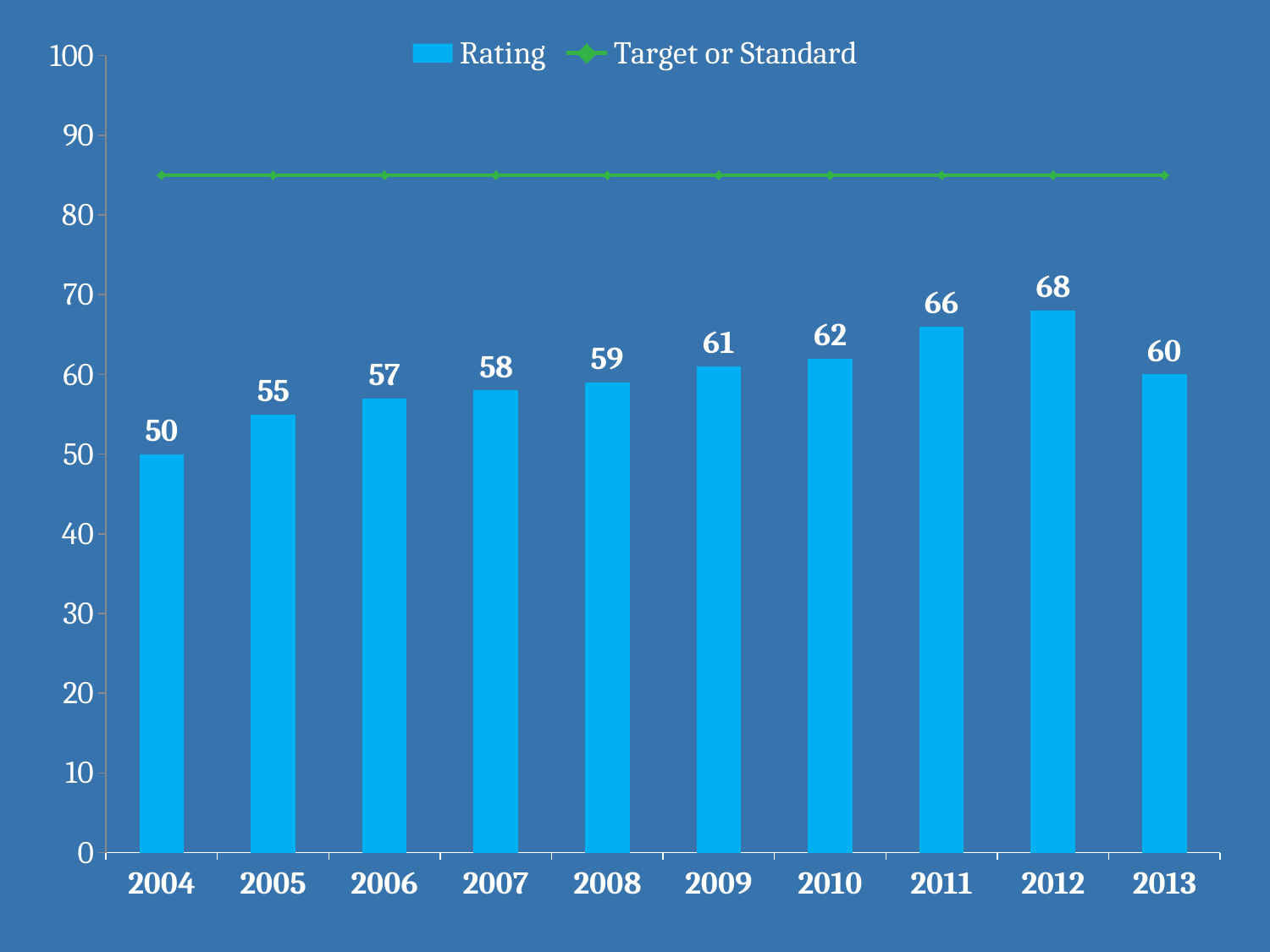
Is the Target or Standard line greater or less than 80? greater What is the Rating value for 2010? 62 What is the Rating value for 2004? 50 How many series does the legend list? 2 Which year has the lowest Rating? 2004 What kind of chart is used to show the Rating series? bar chart How many years are shown on the x axis? 10 What is the difference between the Rating in 2012 and the Rating in 2004? 18 Which year has a higher Rating, 2011 or 2013? 2011 What is the Rating value for 2013? 60 Which year has the highest Rating? 2012 Does the Rating rise or fall from 2004 to 2012? rise